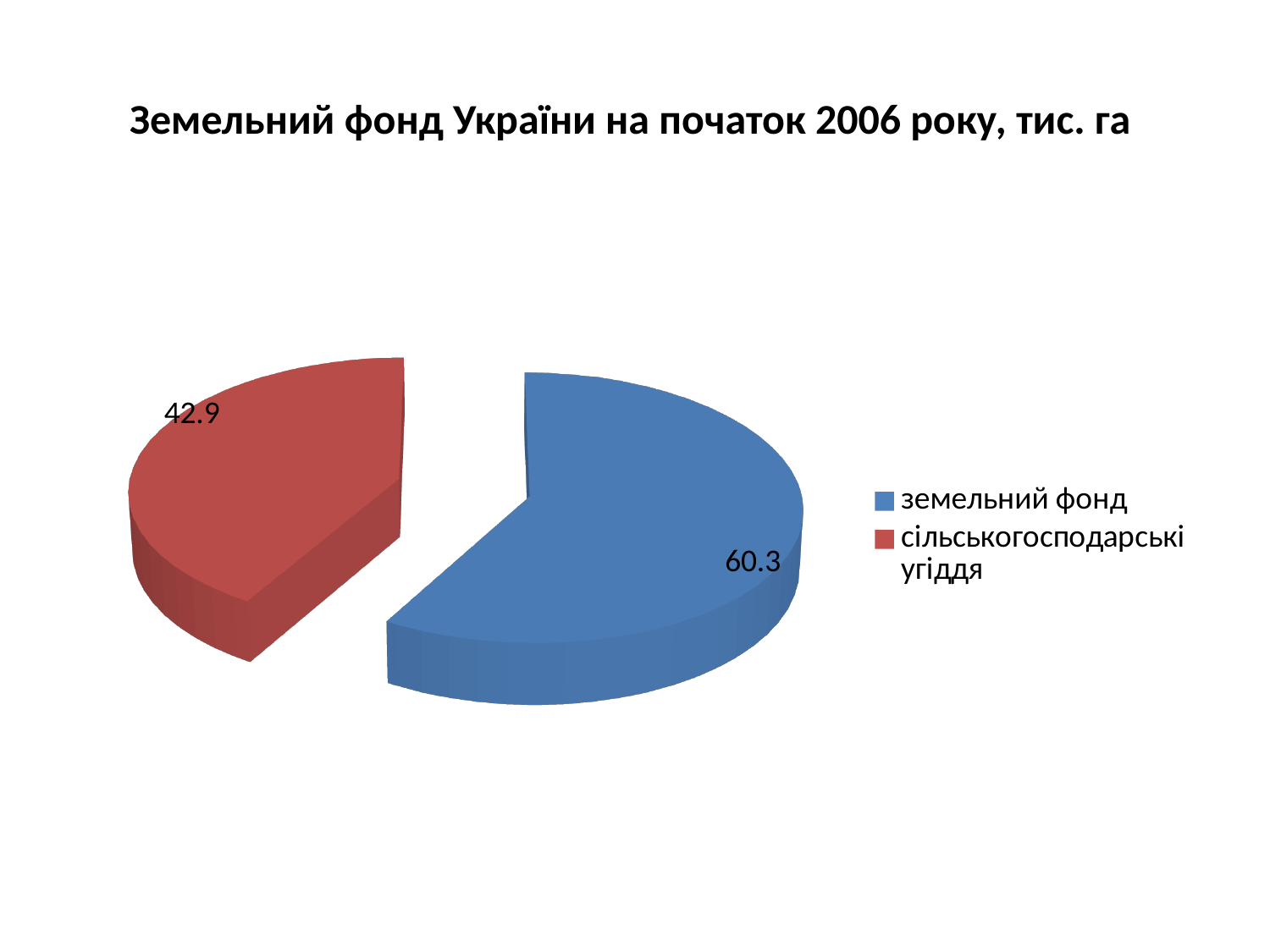
What is the title of the chart? Земельний фонд України на початок 2006 року, тис. га Which is larger: земельний фонд or сільськогосподарські угіддя? земельний фонд How many slices does the pie chart have? 2 What type of chart is shown on the slide? pie chart What is the value for сільськогосподарські угіддя? 42.9 What is the difference between the values for земельний фонд and сільськогосподарські угіддя? 17.4 Which category has the smallest slice of the pie? сільськогосподарські угіддя What colour is the slice for сільськогосподарські угіддя? red Which category has the largest slice of the pie? земельний фонд How many entries does the legend list? 2 What is the total of the two values shown in the pie chart? 103.2 What is the value for земельний фонд? 60.3